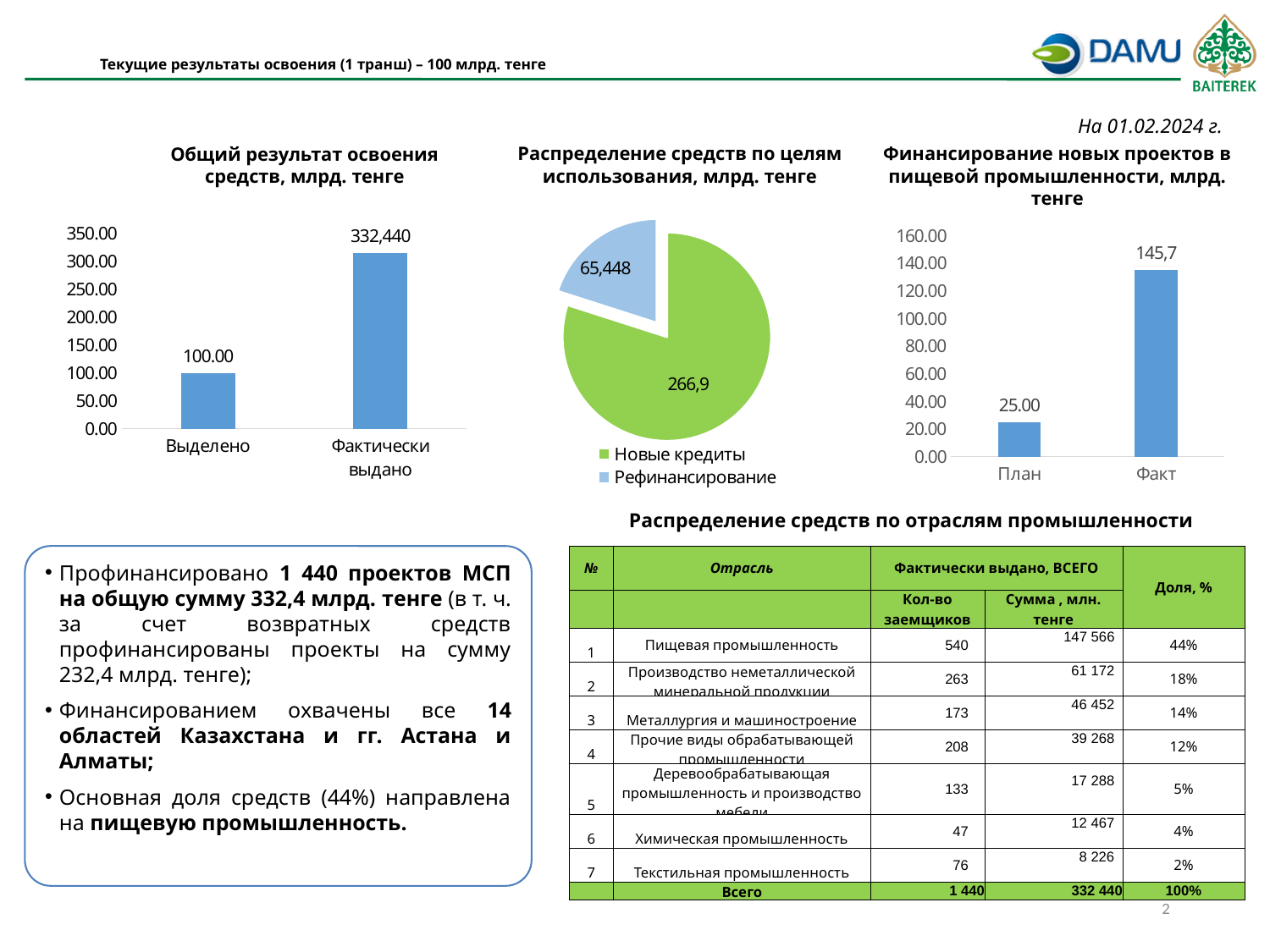
What kind of chart is 'Общий результат освоения средств, млрд. тенге'? bar chart In the chart 'Финансирование новых проектов в пищевой промышленности, млрд. тенге', is the value for 'Факт' greater or less than 140.00? greater How many entries does the legend of the pie chart 'Распределение средств по целям использования, млрд. тенге' list? 2 In the chart 'Общий результат освоения средств, млрд. тенге', what is the value for 'Выделено'? 100.00 In the chart 'Финансирование новых проектов в пищевой промышленности, млрд. тенге', what is the value for 'План'? 25.00 In the pie chart 'Распределение средств по целям использования, млрд. тенге', what is the value for 'Новые кредиты'? 266,9 In the chart 'Общий результат освоения средств, млрд. тенге', what is the value for 'Фактически выдано'? 332,440 In the pie chart 'Распределение средств по целям использования, млрд. тенге', what is the value for 'Рефинансирование'? 65,448 In the chart 'Финансирование новых проектов в пищевой промышленности, млрд. тенге', what is the value for 'Факт'? 145,7 In the chart 'Общий результат освоения средств, млрд. тенге', which category has the higher value? Фактически выдано How many categories are shown on the x axis of the chart 'Финансирование новых проектов в пищевой промышленности, млрд. тенге'? 2 In the pie chart 'Распределение средств по целям использования, млрд. тенге', which slice is the largest? Новые кредиты